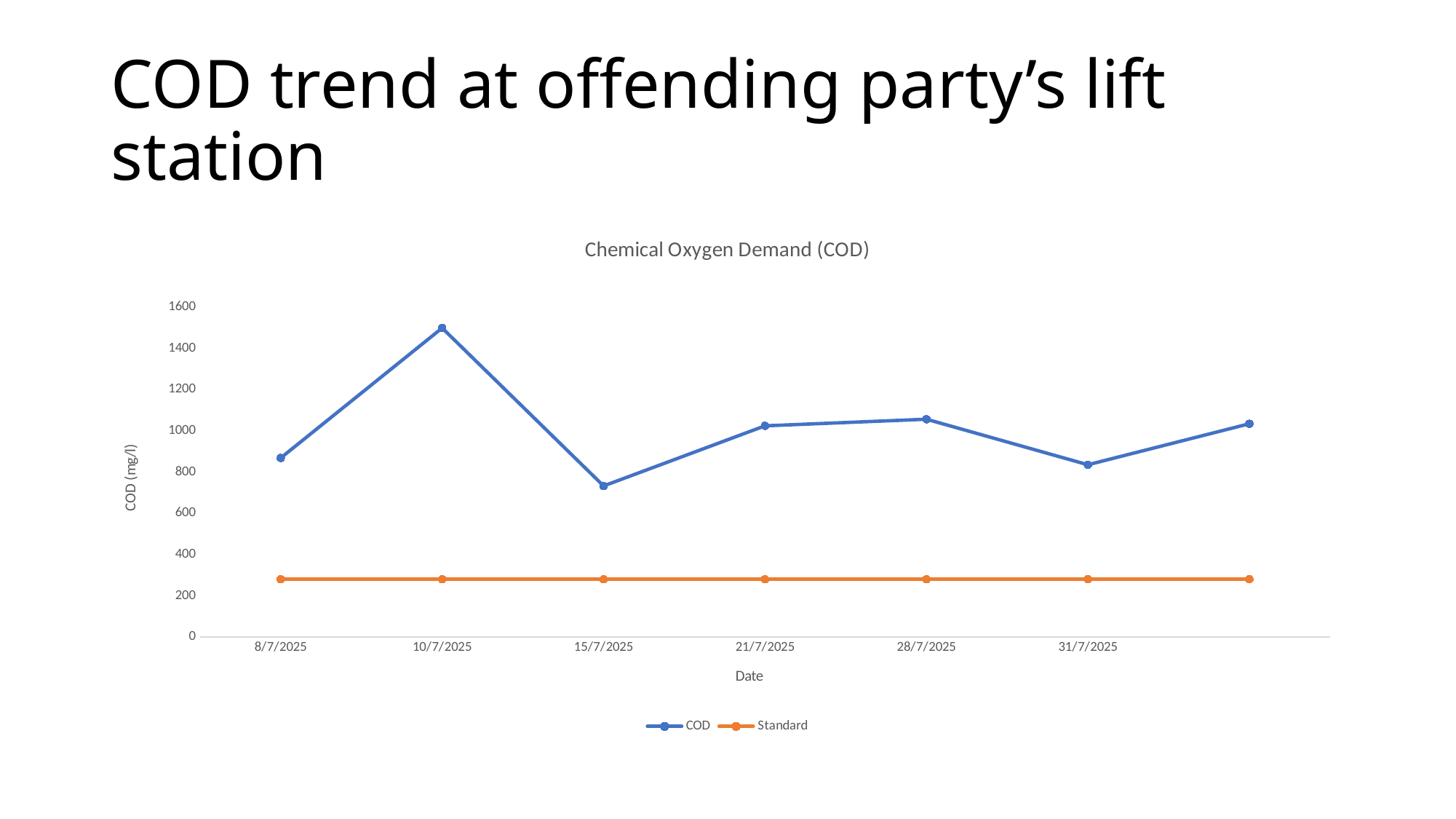
Is the COD value for 31/7/2025 greater or less than 1000? less What are the two series named in the legend? COD and Standard On which date is the COD value highest? 10/7/2025 Is the Standard value greater or less than 400? less Does the COD value rise or fall from 10/7/2025 to 15/7/2025? fall Which is larger, the COD value on 10/7/2025 or on 15/7/2025? 10/7/2025 What is the title of the chart? Chemical Oxygen Demand (COD) What kind of chart is shown on the slide? line chart Is the COD value for 10/7/2025 greater or less than 1400? greater On which labelled date is the COD value lowest? 15/7/2025 How many series does the legend list? 2